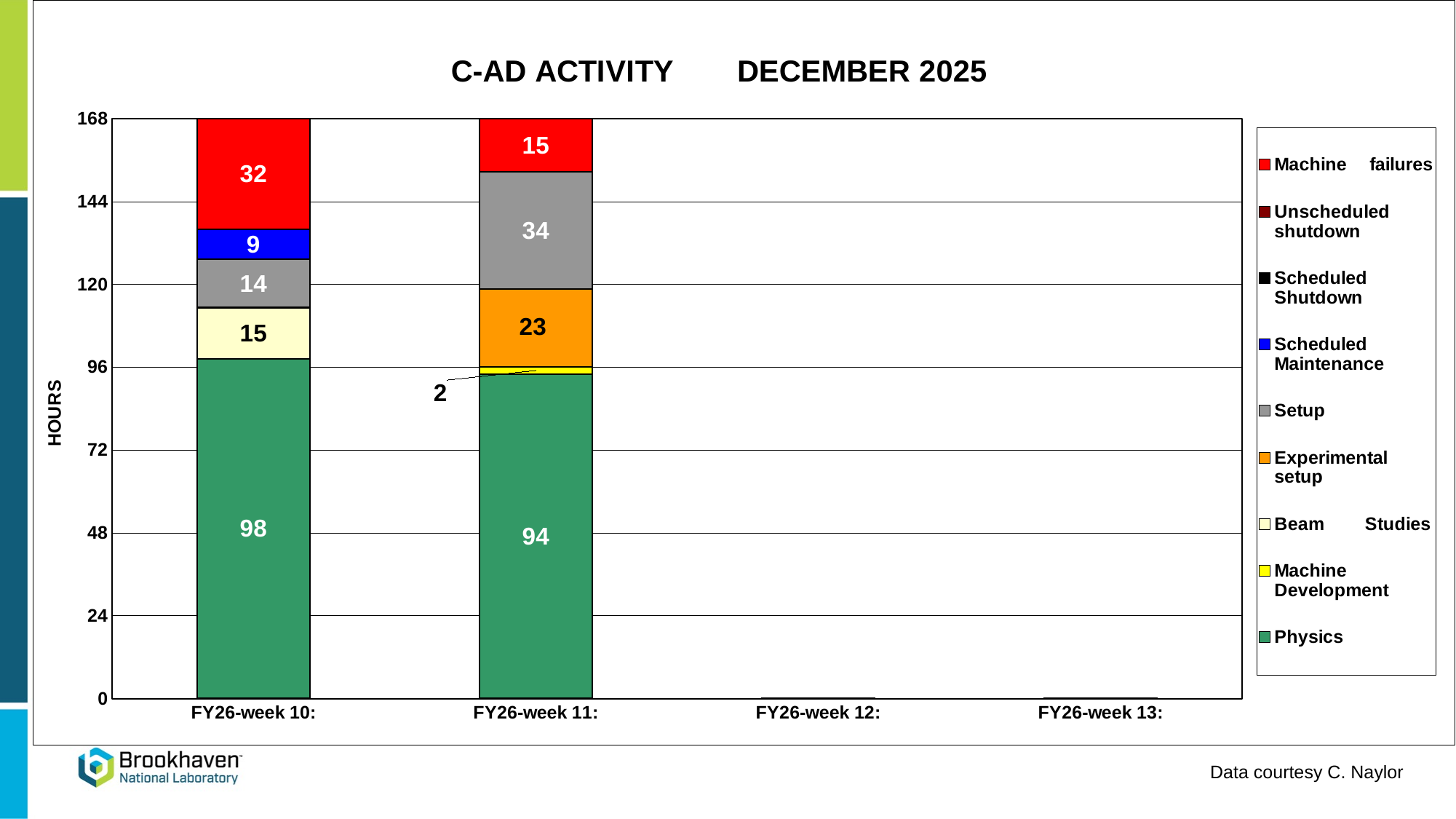
Which week has more Machine failures hours, FY26-week 10 or FY26-week 11? FY26-week 10 What is the total number of hours in the FY26-week 11 bar? 168 How many hours of Experimental setup are shown for FY26-week 11? 23 How many hours of Physics are shown for FY26-week 10? 98 What is the title of the chart? C-AD ACTIVITY DECEMBER 2025 What kind of chart is shown on the slide? stacked bar chart How many week categories are shown on the x axis? 4 How many hours of Scheduled Maintenance are shown for FY26-week 10? 9 How many series does the legend list? 9 How many hours of Machine failures are shown for FY26-week 11? 15 How many hours of Setup are shown for FY26-week 11? 34 What is the difference in Physics hours between FY26-week 10 and FY26-week 11? 4